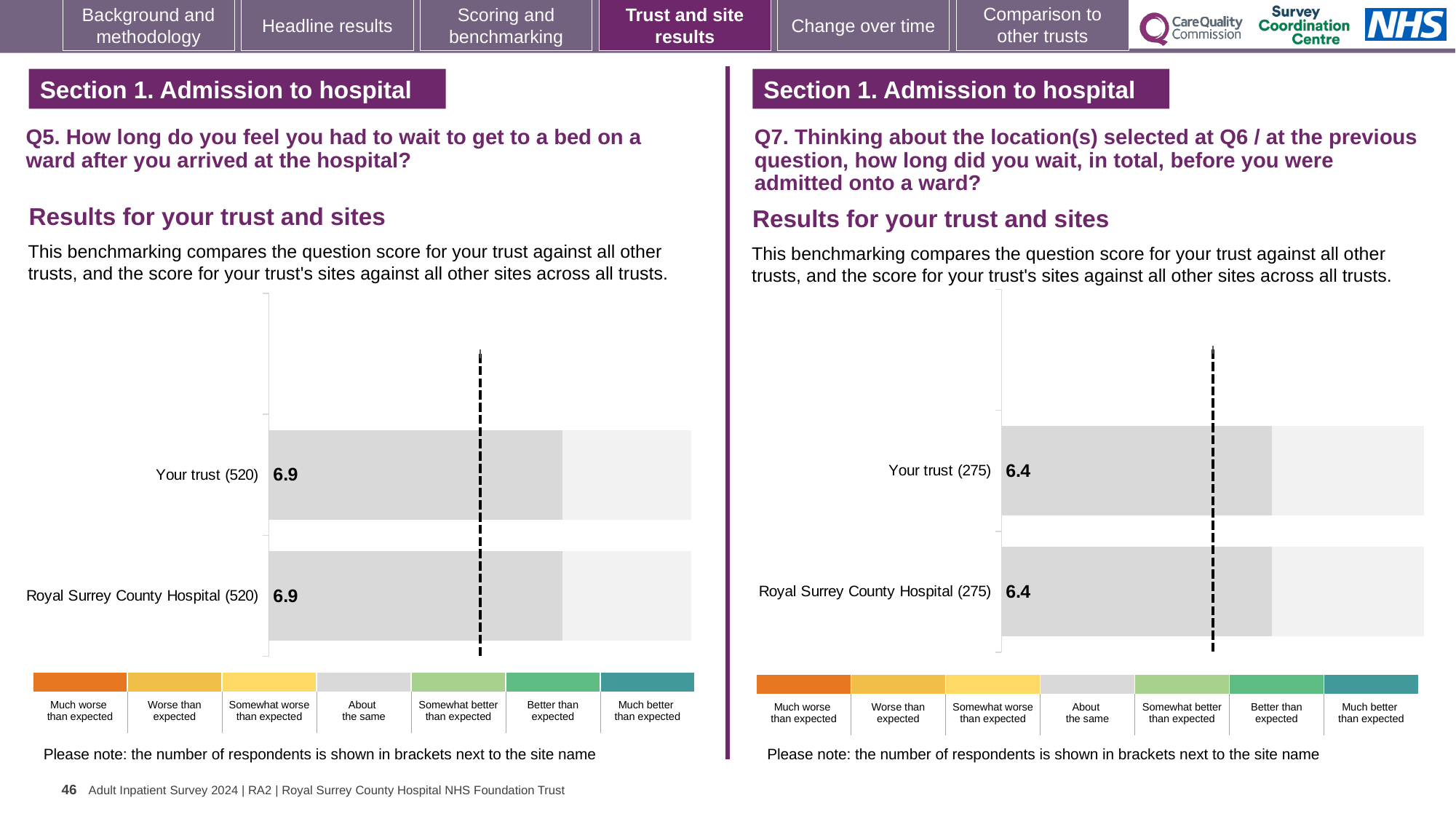
In the Q7 chart on the right, how many respondents are shown in brackets next to Royal Surrey County Hospital? 275 In the Q5 chart on the left, what is the difference between the score for Your trust and the score for Royal Surrey County Hospital? 0.0 In the Q7 chart on the right, what is the difference between the score for Your trust and the score for Royal Surrey County Hospital? 0.0 What kind of chart is the Q5 chart on the left? Bar chart In the Q5 chart on the left, how many bars are plotted? 2 In the Q5 chart on the left, how many respondents are shown in brackets next to Your trust? 520 In the Q5 chart on the left, what is the score for Royal Surrey County Hospital? 6.9 In the Q7 chart on the right, what is the score for Your trust? 6.4 In the Q7 chart on the right, how many bars are plotted? 2 In the Q5 chart on the left, what is the score for Your trust? 6.9 In the Q7 chart on the right, what is the score for Royal Surrey County Hospital? 6.4